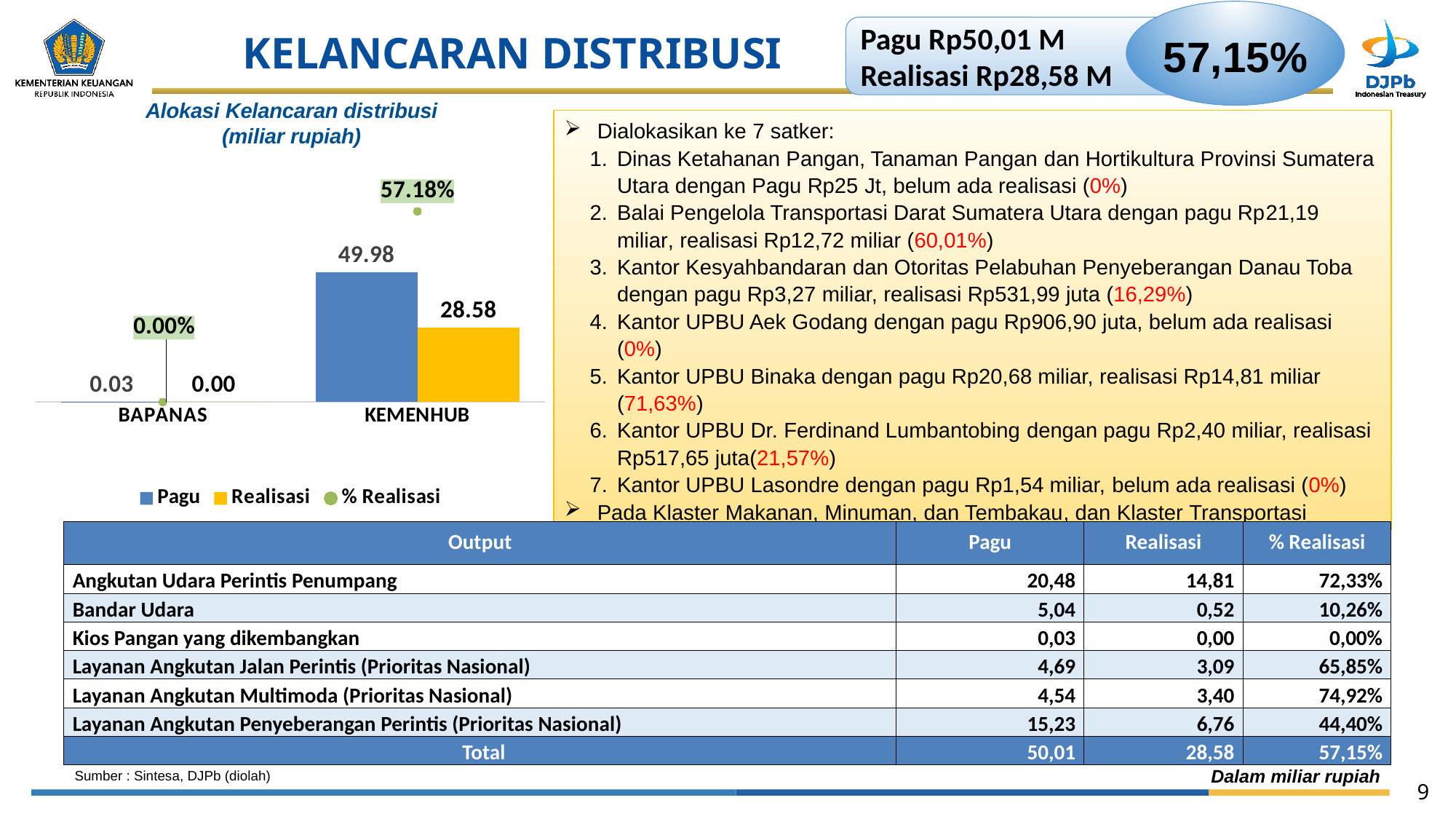
What is the % Realisasi value for BAPANAS in the chart? 0.00% Which is larger for KEMENHUB in the chart, Pagu or Realisasi? Pagu What is the difference between the Pagu and Realisasi values for KEMENHUB in the chart? 21.40 How many series does the chart legend list? 3 What is the title of the chart? Alokasi Kelancaran distribusi (miliar rupiah) Which category has the highest Pagu value in the chart? KEMENHUB What is the Pagu value for BAPANAS in the chart? 0.03 What is the % Realisasi value for KEMENHUB in the chart? 57.18% How many categories are shown on the x axis of the chart? 2 What is the Realisasi value for KEMENHUB in the chart? 28.58 Which category has the lowest Realisasi value in the chart? BAPANAS What is the Pagu value for KEMENHUB in the chart? 49.98